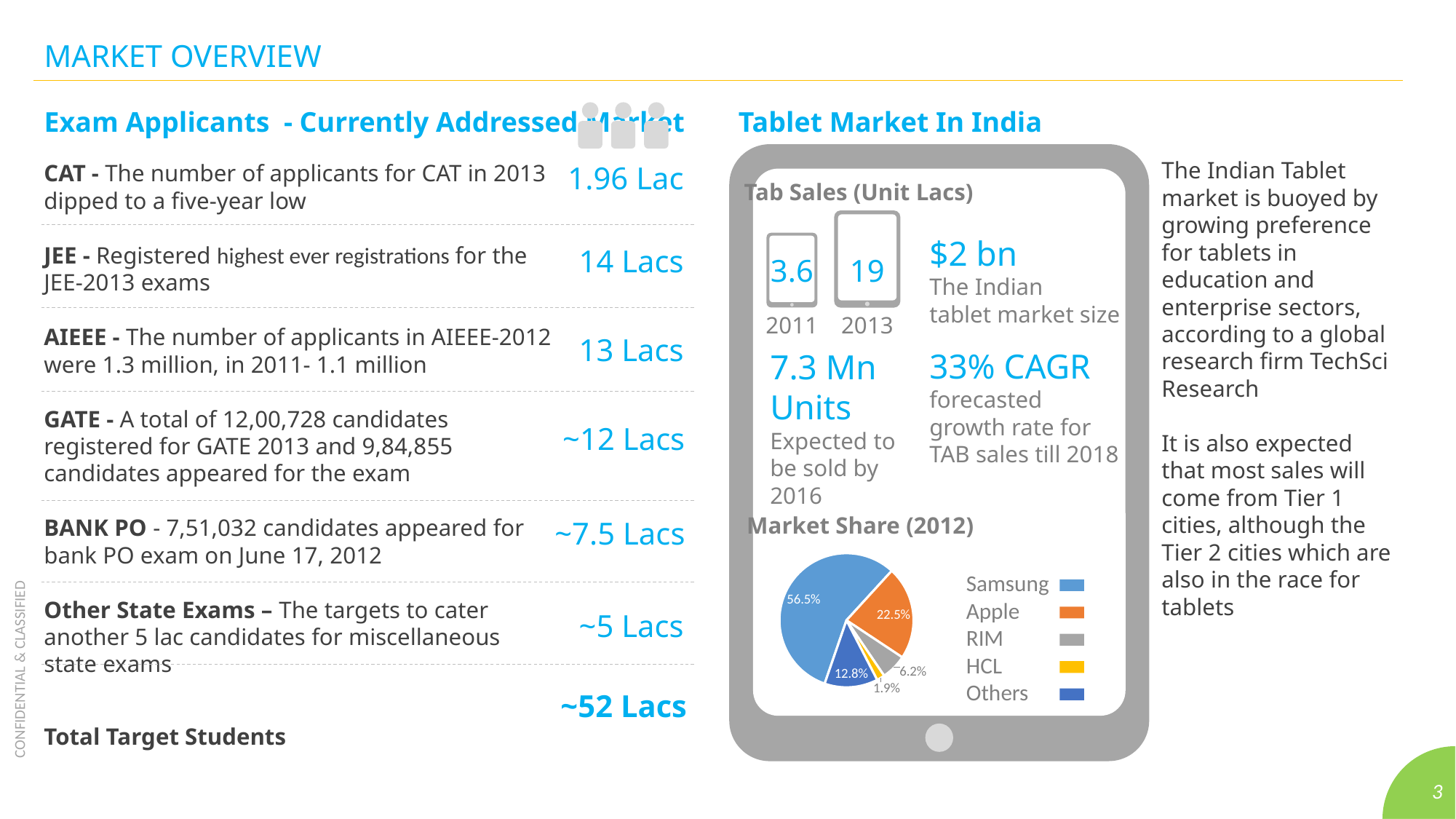
What kind of chart is the Market Share (2012) chart? pie chart How many slices does the Market Share (2012) pie chart have? 5 In the Market Share (2012) pie chart, what is HCL's share? 1.9% In the Market Share (2012) pie chart, which company has the smallest share? HCL In the Market Share (2012) pie chart, what is Apple's share? 22.5% In the Market Share (2012) pie chart, what colour is the Apple slice? orange In the Market Share (2012) pie chart, what is the share for Others? 12.8% In the Market Share (2012) pie chart, what is the difference between Samsung's share and Apple's share? 34.0% In the Market Share (2012) pie chart, what is Samsung's share? 56.5% In the Market Share (2012) pie chart, what is RIM's share? 6.2% In the Market Share (2012) pie chart, which is larger, the share for Others or the share for RIM? Others In the Market Share (2012) pie chart, which company has the largest share? Samsung